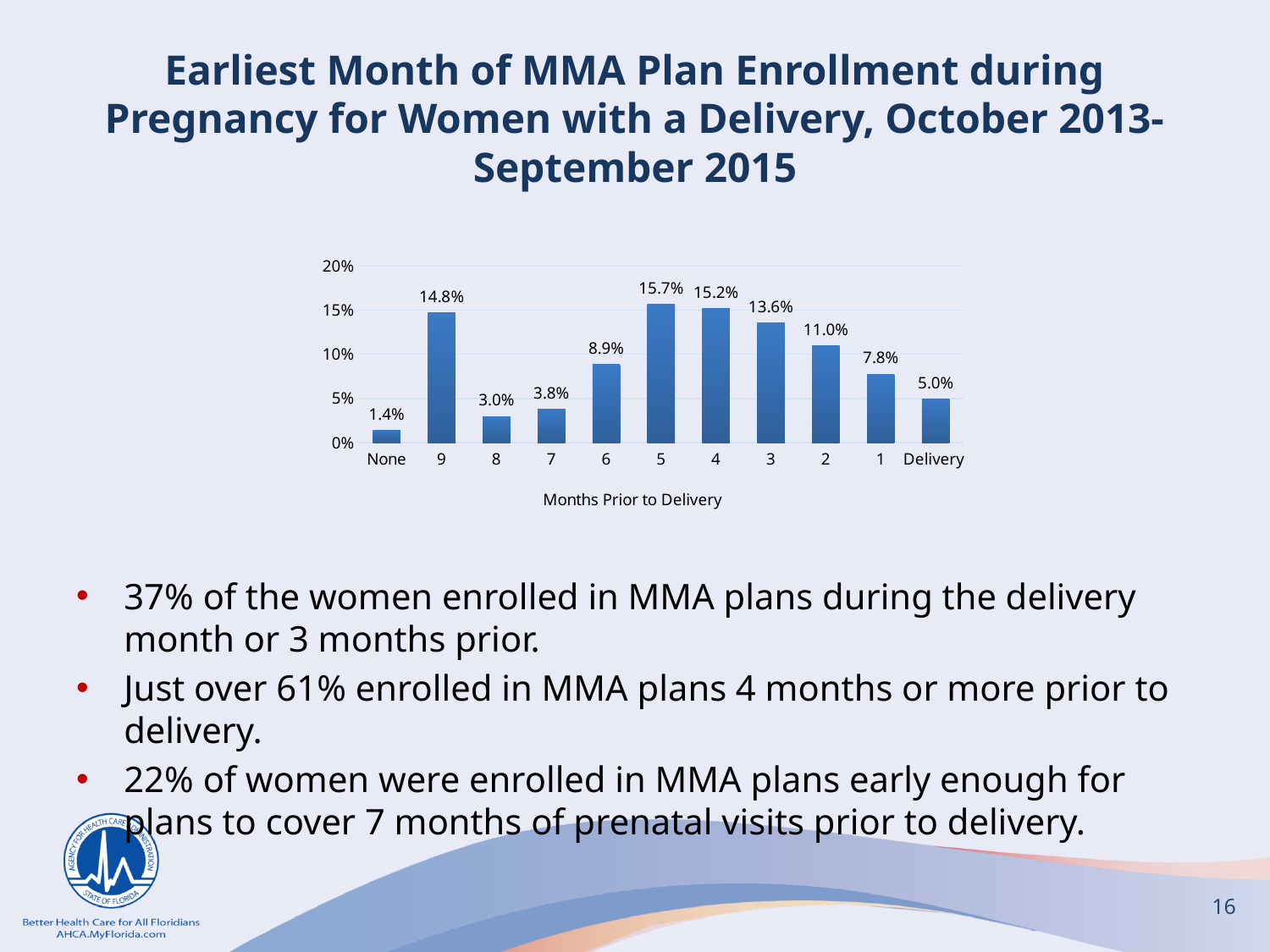
What is the label of the x axis of the chart? Months Prior to Delivery From 5 months prior to delivery through to the Delivery category, do the values rise or fall along the x axis? fall What percentage of women had their earliest MMA plan enrollment 9 months prior to delivery? 14.8% How many categories are shown on the x axis of the chart? 11 What is the value shown for the 'None' category? 1.4% Is the value for 6 months prior to delivery greater or less than 10%? less Which category has the highest value in the chart? 5 What percentage is shown for the 'Delivery' category? 5.0% What is the difference between the values for 5 months and 4 months prior to delivery? 0.5% What kind of chart is shown on the slide? bar chart Which is larger, the value for 3 months prior to delivery or the value for 2 months prior to delivery? 3 Which category has the lowest value in the chart? None